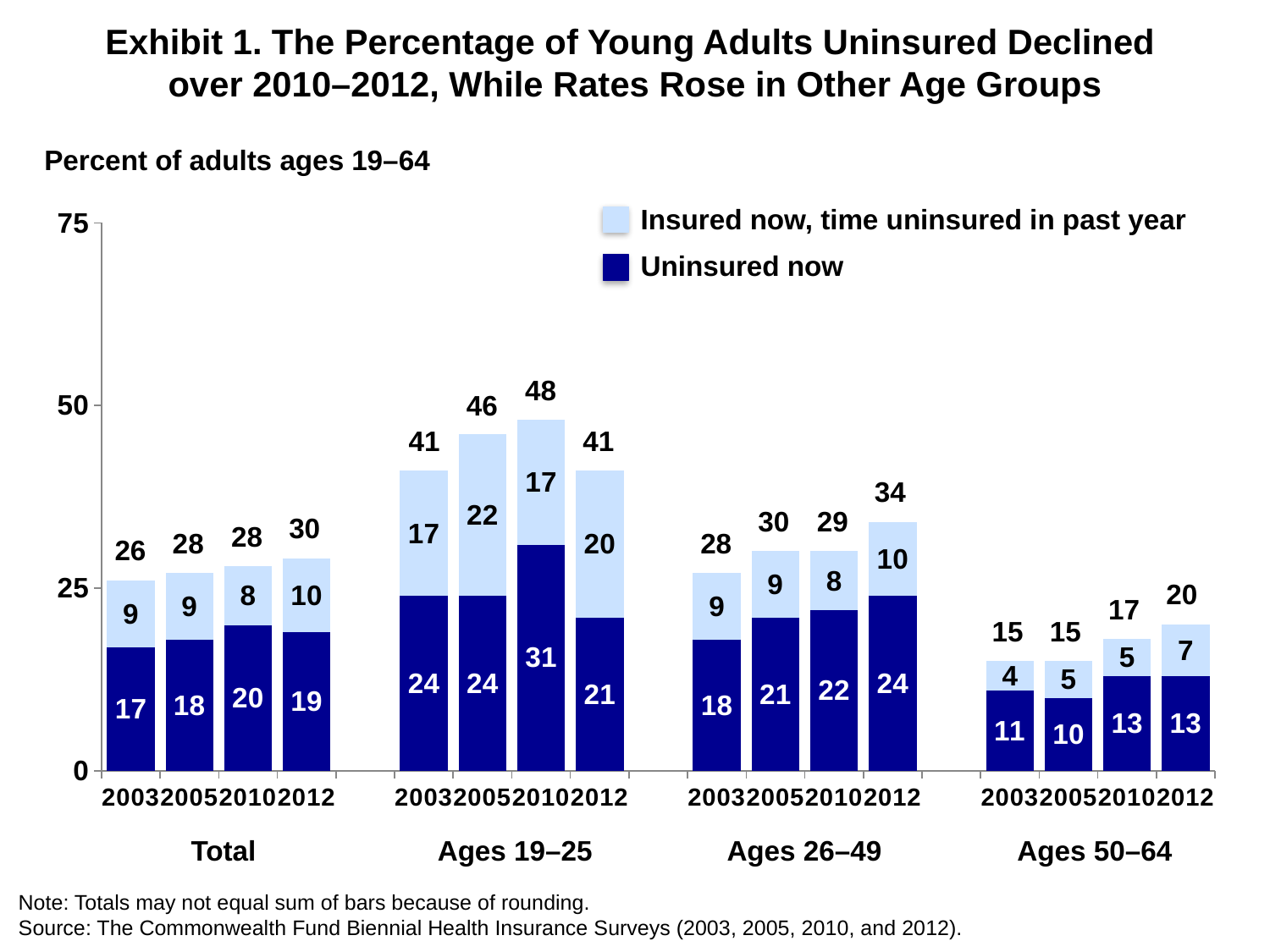
What is the "Uninsured now" value for Ages 19–25 in 2010? 31 In the Ages 50–64 group, which year has the lowest "Uninsured now" value? 2005 How many age groups are shown along the x axis? 4 What kind of chart is shown on the slide? Stacked bar chart For Ages 26–49, does the "Uninsured now" value rise or fall from 2003 to 2012? Rise In the Total group, is the "Uninsured now" value larger in 2010 or in 2012? 2010 What is the "Insured now, time uninsured in past year" value for Ages 50–64 in 2012? 7 How many series does the legend list? 2 What total is printed above the 2012 bar for Ages 26–49? 34 Which colour represents "Uninsured now" in the legend? Dark blue For Ages 19–25, how much higher is the "Uninsured now" value in 2010 than in 2012? 10 In the Ages 19–25 group, which year has the highest total? 2010